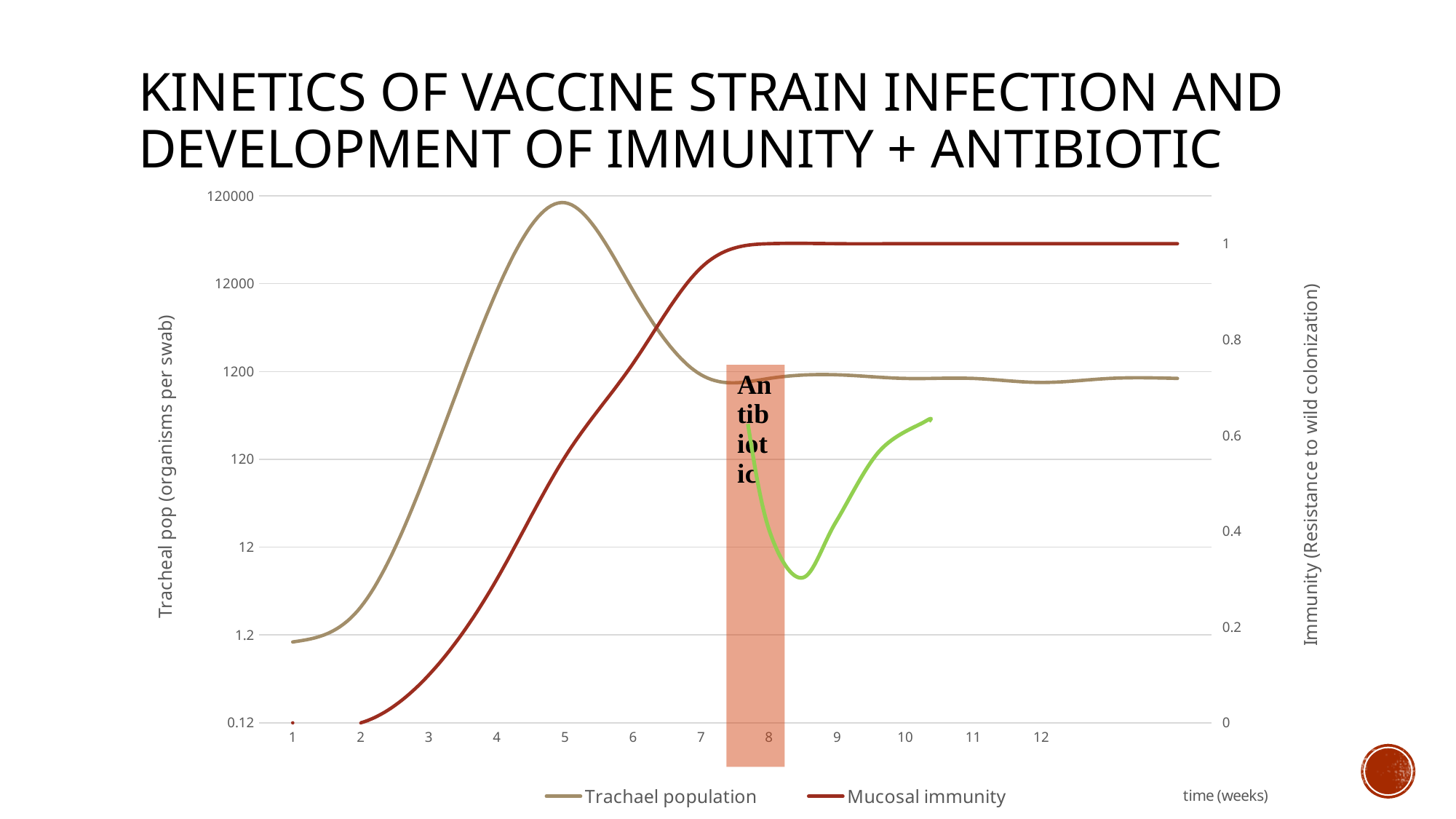
Is the Mucosal immunity at week 5 greater or less than 0.4? greater Is the Mucosal immunity at week 2 greater or less than 0.2? less What label is written on the shaded vertical band around week 8? Antibiotic Does the Trachael population line rise or fall between week 5 and week 7? falls At which week does the Trachael population line reach its peak? 5 Is the Trachael population at week 1 greater or less than 12? less What kind of chart is shown on the slide? line chart What are the two series named in the legend? Trachael population and Mucosal immunity How many series does the legend list? 2 Does the Mucosal immunity line rise or fall between week 2 and week 8? rises